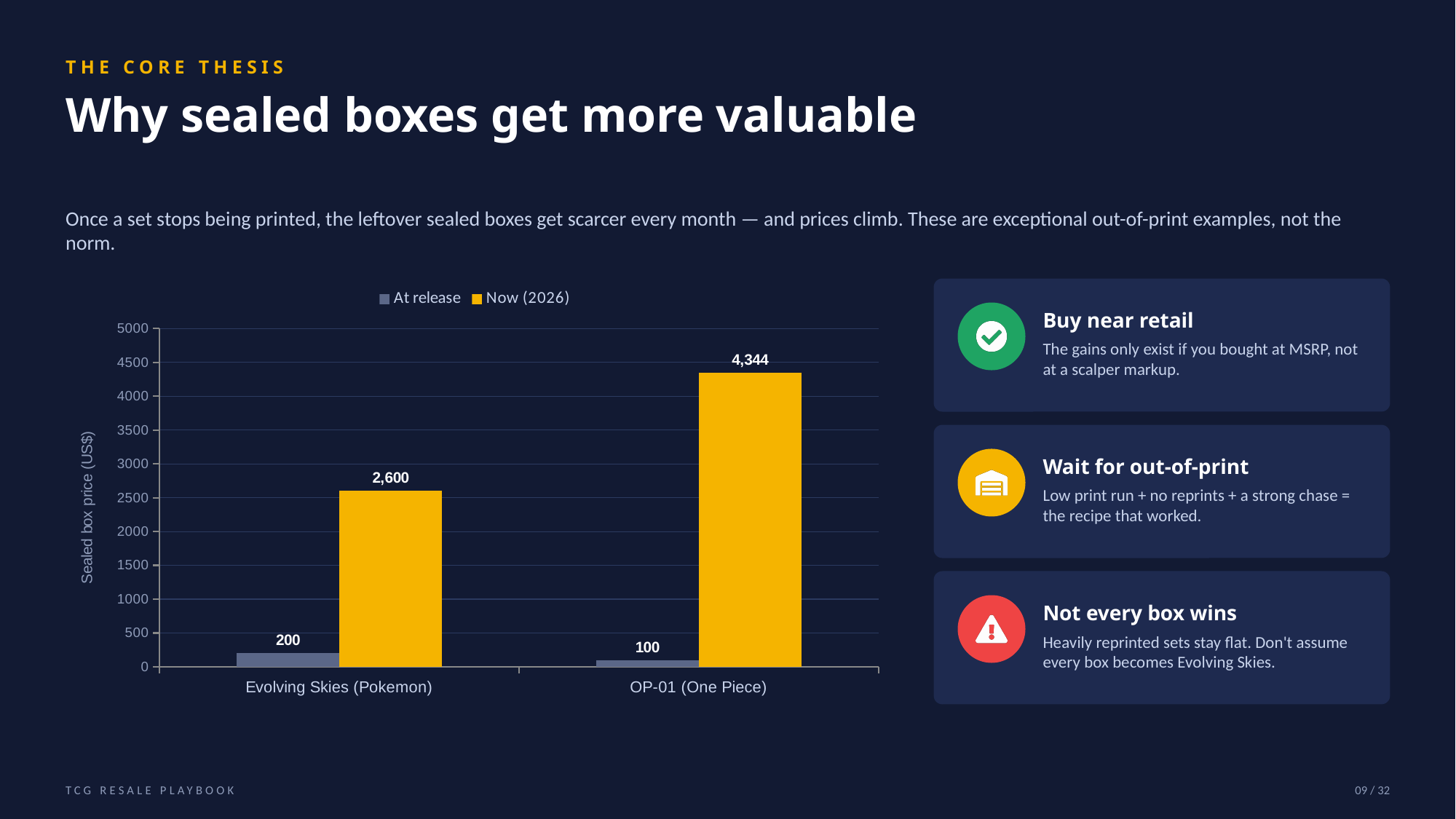
What is the difference between the 'Now (2026)' and 'At release' values for OP-01 (One Piece)? 4,244 Which is larger: the 'At release' value for Evolving Skies (Pokemon) or the 'At release' value for OP-01 (One Piece)? Evolving Skies (Pokemon) How many series does the chart legend list? 2 How many categories are shown on the x axis of the chart? 2 Which category has the lowest 'At release' value? OP-01 (One Piece) Which category has the highest 'Now (2026)' value? OP-01 (One Piece) What is the 'At release' sealed box price for Evolving Skies (Pokemon)? 200 What is the 'Now (2026)' sealed box price for OP-01 (One Piece)? 4,344 What is the 'At release' sealed box price for OP-01 (One Piece)? 100 What is the 'Now (2026)' sealed box price for Evolving Skies (Pokemon)? 2,600 What is the difference between the 'Now (2026)' values for OP-01 (One Piece) and Evolving Skies (Pokemon)? 1,744 What type of chart is shown on the slide? Bar chart